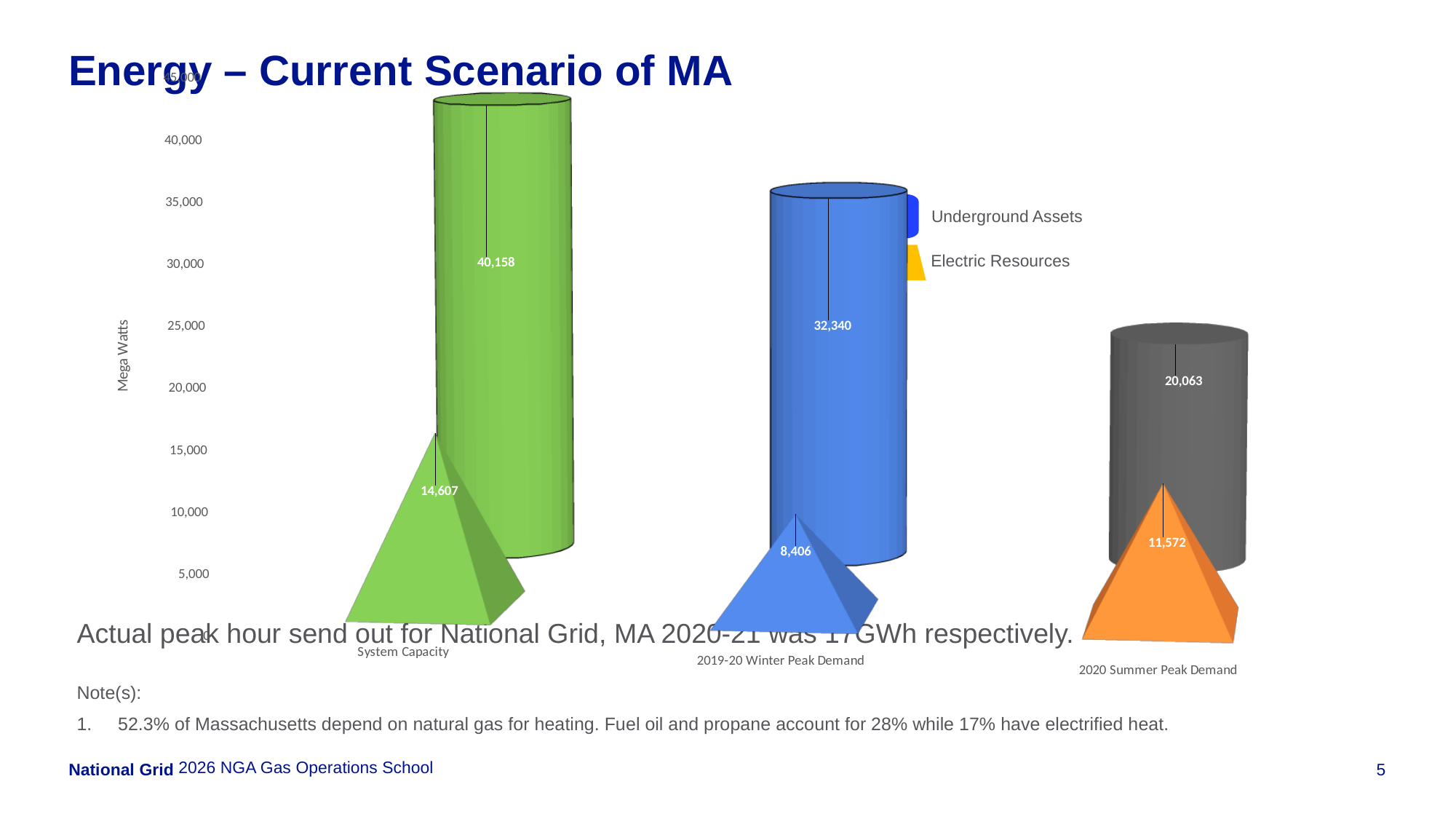
What is the value of the pyramid for 2019-20 Winter Peak Demand? 8,406 How many series does the chart legend list? 2 What is the difference between the pyramid values for 2020 Summer Peak Demand and 2019-20 Winter Peak Demand? 3,166 Which is larger: the pyramid value for System Capacity or the pyramid value for 2020 Summer Peak Demand? System Capacity What is the value of the cylinder for System Capacity? 40,158 What is the difference between the cylinder values for System Capacity and 2019-20 Winter Peak Demand? 7,818 How many categories are shown on the x axis of the chart? 3 Which category has the lowest pyramid value? 2019-20 Winter Peak Demand Which category has the highest cylinder value? System Capacity What is the value of the cylinder for 2020 Summer Peak Demand? 20,063 What is the value of the pyramid for System Capacity? 14,607 What is the label on the vertical axis of the chart? Mega Watts